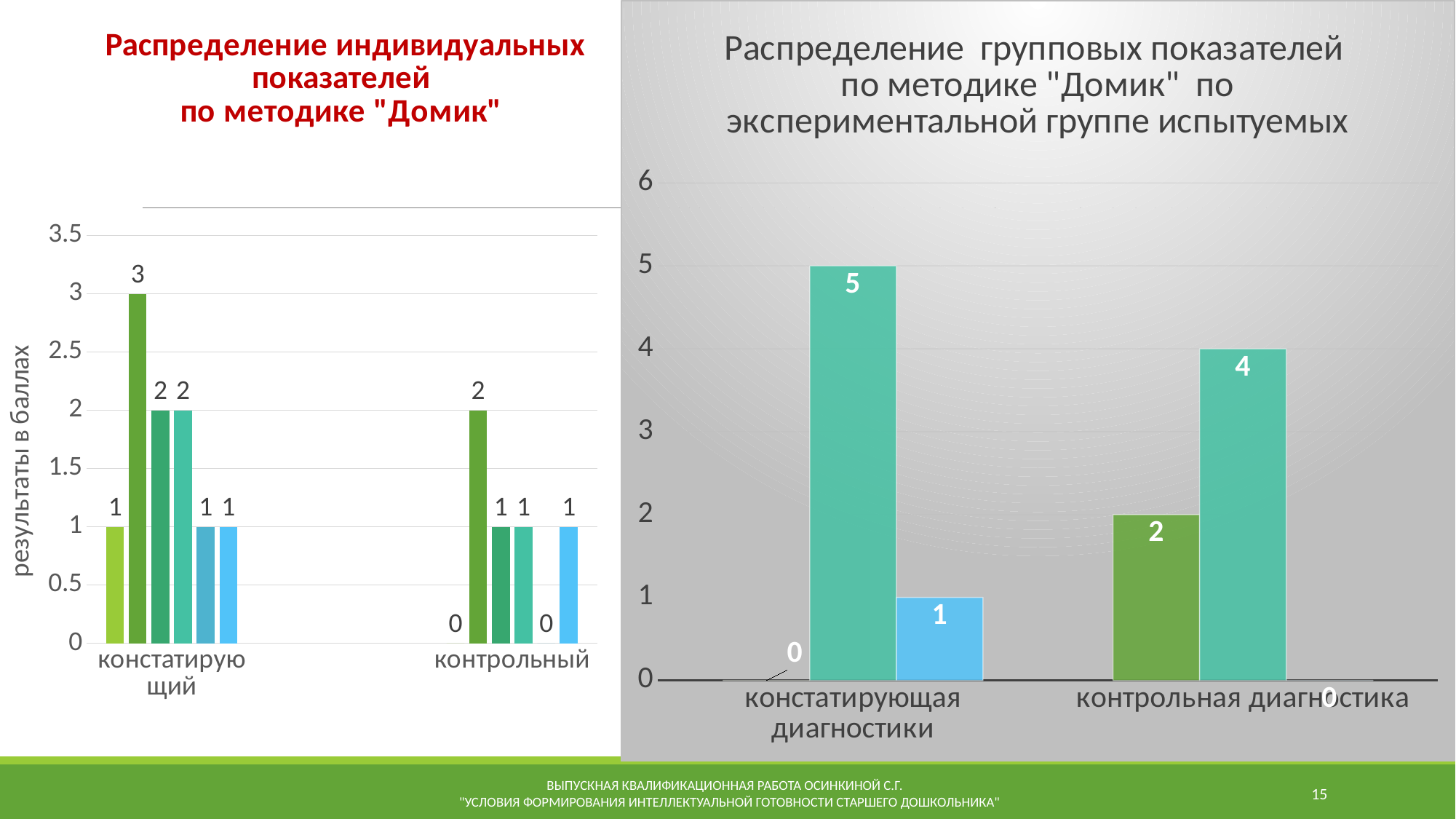
In the right chart, what is the value of the light blue bar in the "констатирующая диагностики" group? 1 What kind of chart is the left chart, "Распределение индивидуальных показателей по методике "Домик""? bar chart In the right chart, which is larger: the green bar in "контрольная диагностика" or the light blue bar in "констатирующая диагностики"? the green bar in контрольная диагностика In the right chart, what is the highest value labelled on any bar? 5 In the right chart, what is the value of the tallest bar in the "контрольная диагностика" group? 4 In the left chart, what is the label of the y axis? результаты в баллах What kind of chart is the right chart, "Распределение групповых показателей по методике "Домик""? bar chart In the left chart, how many categories are shown on the x axis? 2 In the right chart, what is the difference between the tallest bar in "констатирующая диагностики" (5) and the tallest bar in "контрольная диагностика" (4)? 1 In the right chart, how many categories are shown on the x axis? 2 In the left chart, what is the highest value labelled in the "констатирующий" group? 3 In the left chart, what is the highest value labelled in the "контрольный" group? 2